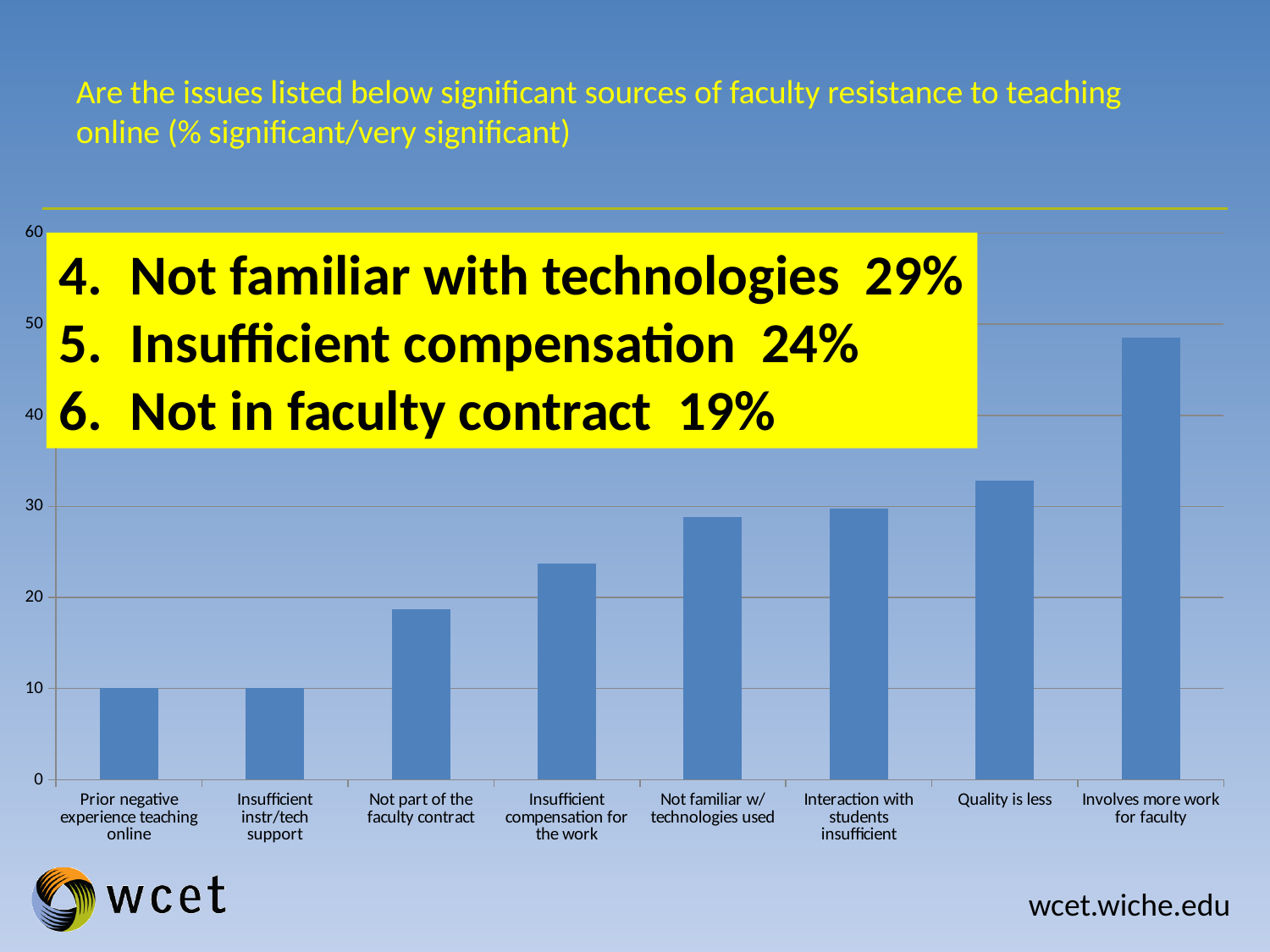
According to the highlighted text on the slide, what percentage is given for "Not familiar with technologies"? 29% Do the bar values generally rise or fall moving from left to right along the x axis? rise What kind of chart is shown on the slide? bar chart According to the highlighted text on the slide, what percentage is given for "Insufficient compensation"? 24% Which is larger: the value for "Quality is less" or the value for "Not familiar w/ technologies used"? Quality is less Which issue has the highest bar on the chart? Involves more work for faculty Is the value for "Quality is less" greater or less than 30? greater Is the value for "Involves more work for faculty" greater or less than 50? less What question does the slide title say the chart is answering? Are the issues listed below significant sources of faculty resistance to teaching online (% significant/very significant) How many categories (issues) are plotted on the chart? 8